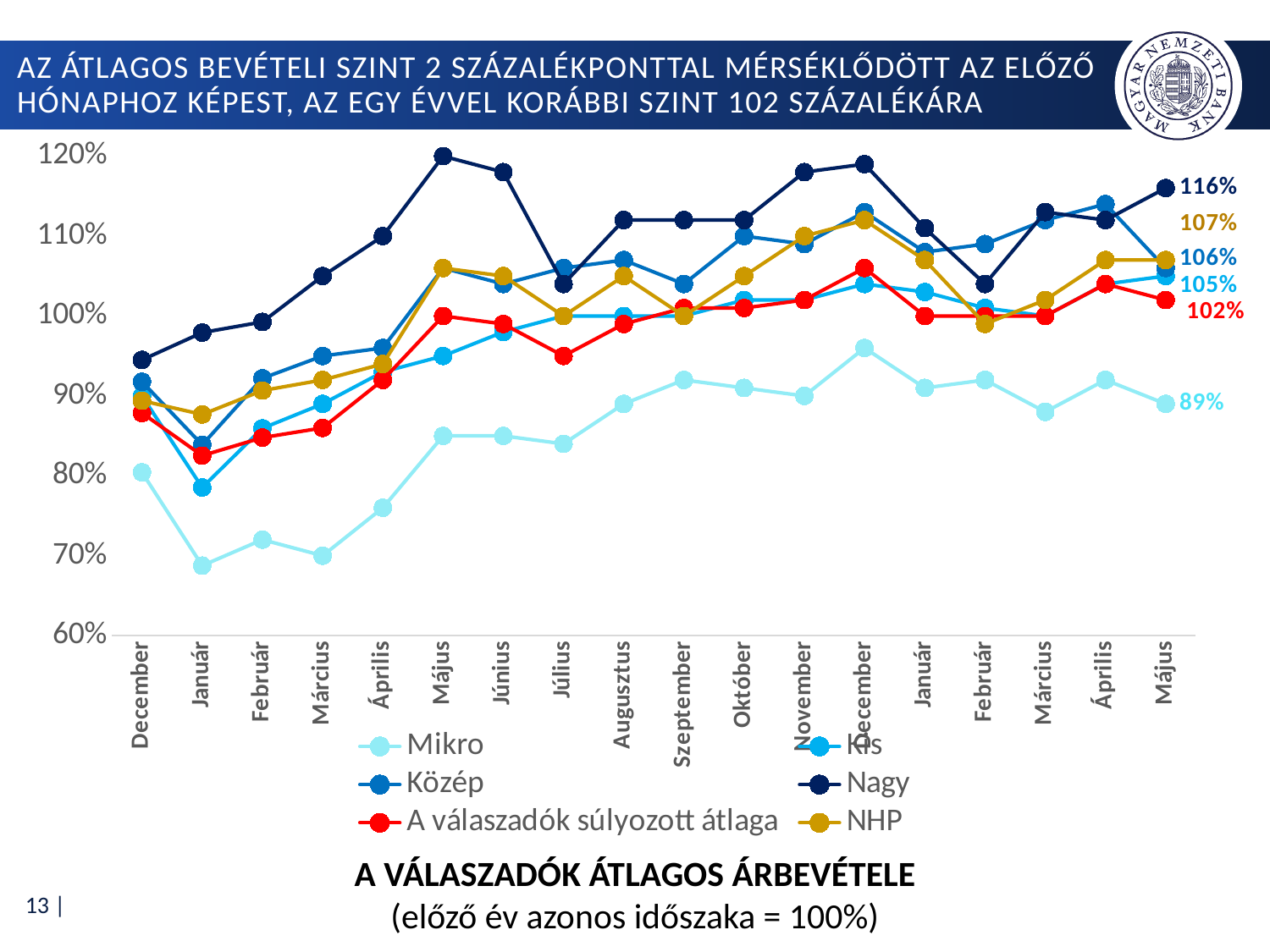
What is the value shown for 'A válaszadók súlyozott átlaga' at the final Május point? 102% Is the value for Nagy in the first Május greater or less than 110%? greater How many series does the legend list? 6 Is the value for Mikro in the first Január greater or less than 70%? less Which series has the lowest value at the final Május point? Mikro What is the value shown for the NHP series at the final Május point? 107% What is the value shown for the Nagy series at the final Május point? 116% What kind of chart is shown on the slide? Line chart At the final Május point, which is larger: the Közép value or the Kis value? Közép What is the difference between the Nagy and Mikro values at the final Május point? 27 percentage points What is the value shown for the Mikro series at the final Május point? 89% Which series has the highest value at the final Május point? Nagy